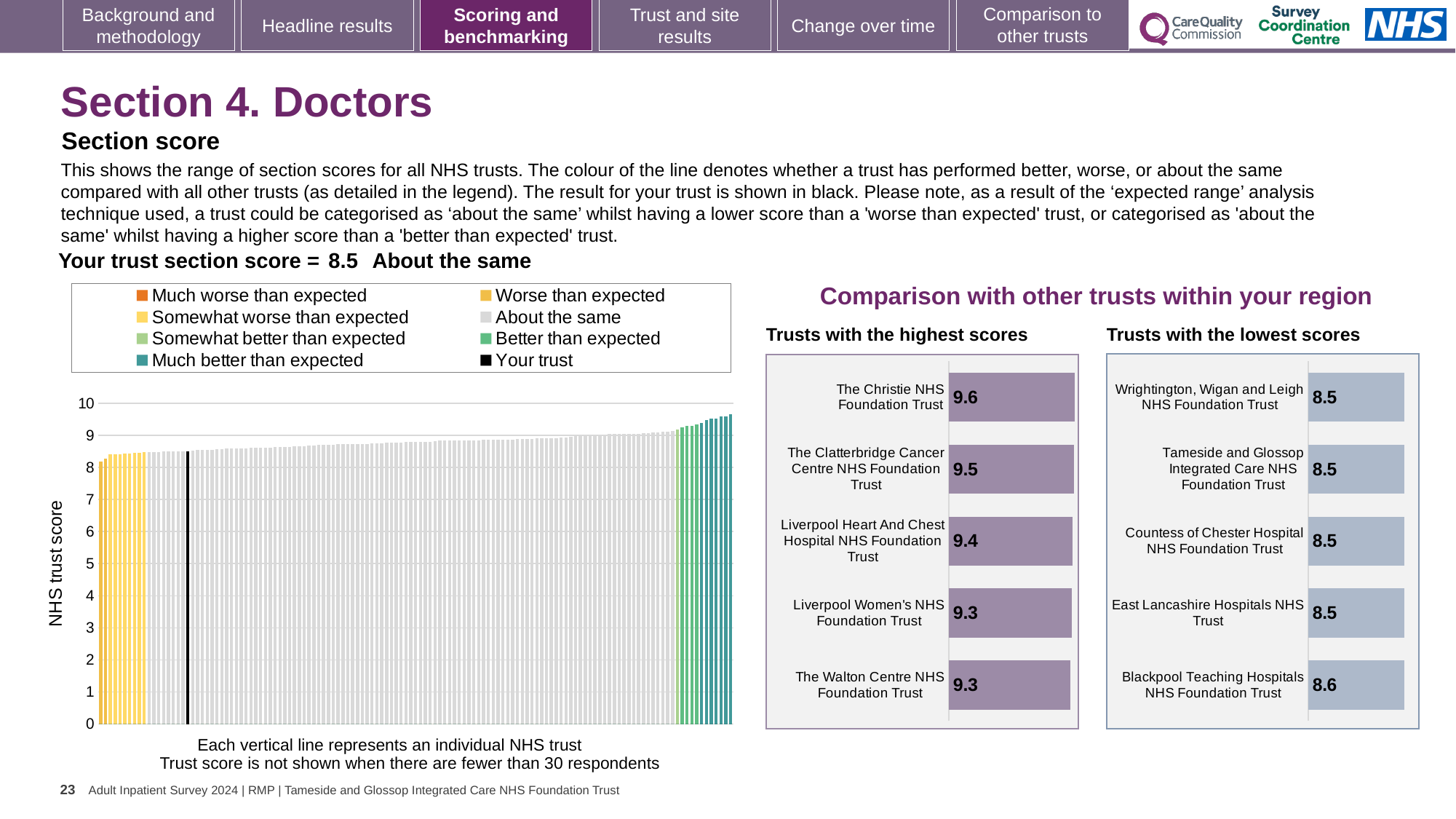
In the 'Trusts with the highest scores' chart, what is the score for The Christie NHS Foundation Trust? 9.6 In the 'Trusts with the highest scores' chart, which has the larger score: The Christie NHS Foundation Trust or The Clatterbridge Cancer Centre NHS Foundation Trust? The Christie NHS Foundation Trust In the 'Trusts with the highest scores' chart, what is the score for Liverpool Heart And Chest Hospital NHS Foundation Trust? 9.4 In the large chart on the left, do the NHS trust scores rise or fall from left to right? Rise In the 'Trusts with the lowest scores' chart, what is the score for Blackpool Teaching Hospitals NHS Foundation Trust? 8.6 How many trusts are shown in the 'Trusts with the lowest scores' chart? 5 What kind of chart is the large chart on the left showing NHS trust scores? Bar chart In the 'Trusts with the lowest scores' chart, which trust has the highest score? Blackpool Teaching Hospitals NHS Foundation Trust How many entries does the legend of the large chart on the left list? 8 In the 'Trusts with the highest scores' chart, which trust has the highest score? The Christie NHS Foundation Trust In the large chart on the left, is the value for the black 'Your trust' bar greater or less than 9? less In the 'Trusts with the highest scores' chart, what is the difference between the scores of The Christie NHS Foundation Trust and The Walton Centre NHS Foundation Trust? 0.3